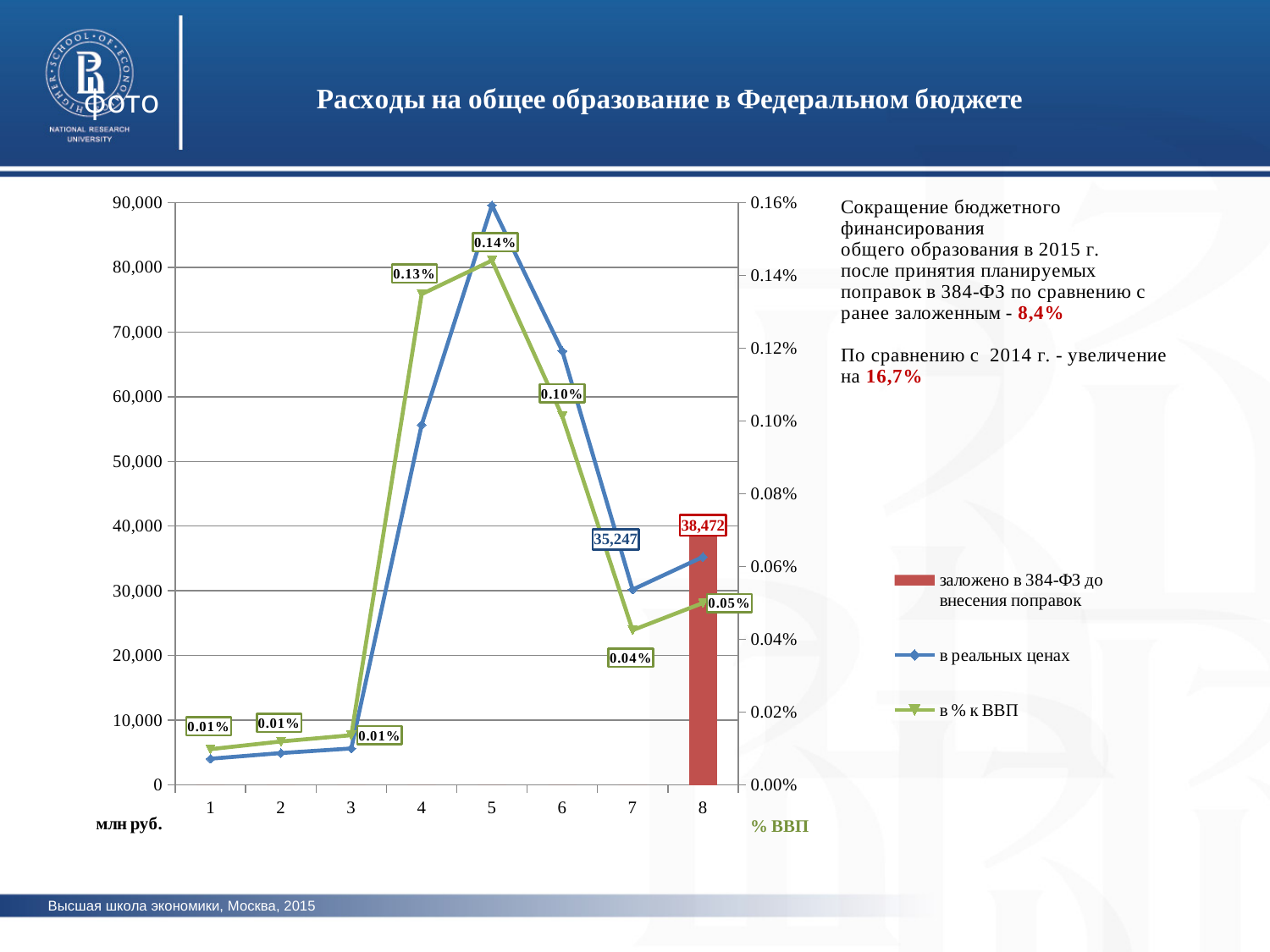
What is the difference between the 'в % к ВВП' values at category 5 and category 6? 0.04% What value is labelled on the red bar 'заложено в 384-ФЗ до внесения поправок' at category 8? 38,472 How many series does the legend list? 3 What is the value of 'в % к ВВП' at category 7? 0.04% At which category does the 'в % к ВВП' series reach its highest value? 5 Does the 'в % к ВВП' series rise or fall from category 5 to category 7? fall How many categories are shown on the x axis? 8 Is the value of 'в реальных ценах' at category 5 greater or less than 80,000? greater What unit label is shown under the left axis of the chart? млн руб. What kind of chart is shown on the slide? combination of line and bar chart What is the value of 'в % к ВВП' at category 4? 0.13% What is the value of 'в % к ВВП' at category 5? 0.14%